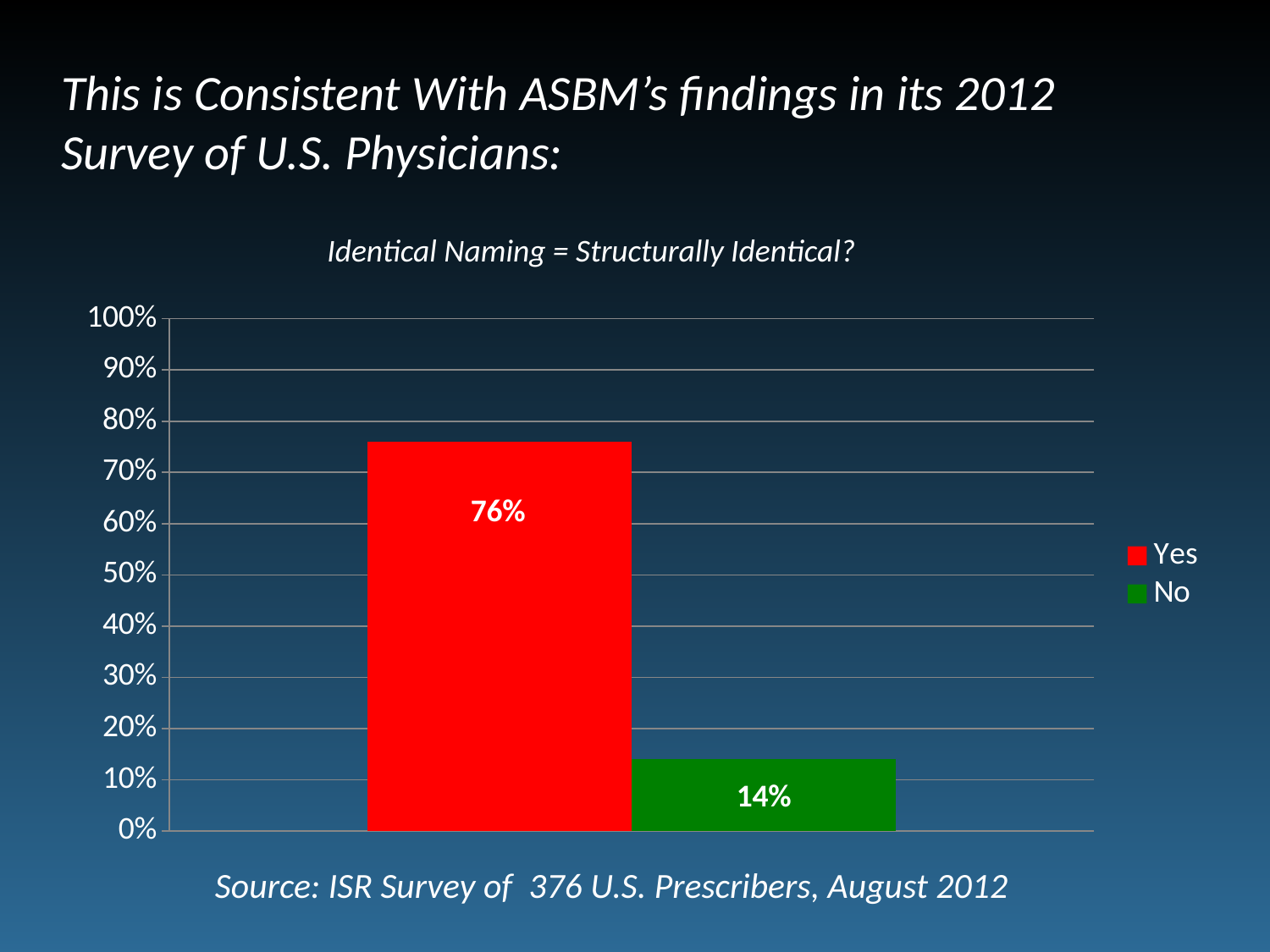
What is the difference between the Yes and No percentages? 62% How many series does the legend list? 2 What is the highest value shown on the vertical axis? 100% Which response has the higher value, Yes or No? Yes What kind of chart is shown on the slide? bar chart What percentage of respondents answered Yes? 76% Which response has the lowest value? No What percentage of respondents answered No? 14% What is the title of the chart? Identical Naming = Structurally Identical? Is the value for No greater or less than 20%? less Is the value for Yes greater or less than 50%? greater What colour is the bar for No? green